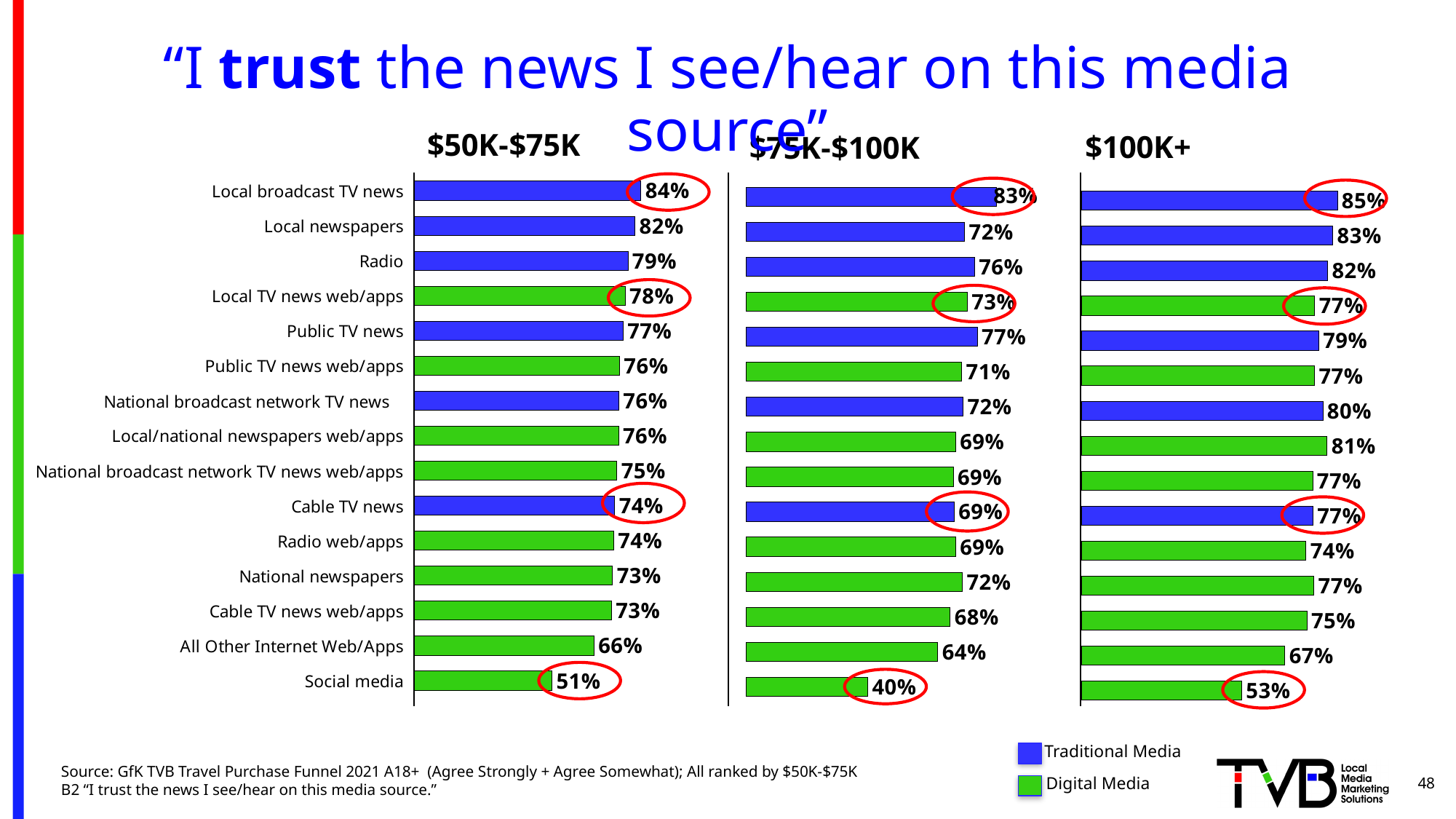
In the $50K-$75K chart, what is the value for Local broadcast TV news? 84% What kind of chart is used on this slide? Bar chart In the $75K-$100K chart, what is the value for Social media? 40% How many categories are shown in each chart? 15 In the $100K+ chart, what is the value for Cable TV news? 77% In the $100K+ chart, which category has the highest value? Local broadcast TV news In the $50K-$75K chart, which is larger: Local newspapers or Radio? Local newspapers In the $75K-$100K chart, what is the difference between Local broadcast TV news and Social media? 43 percentage points In the $75K-$100K chart, what is the value for Radio? 76% In the $50K-$75K chart, which category has the lowest value? Social media How many series does the legend list? 2 In the $100K+ chart, what is the difference between Local newspapers and All Other Internet Web/Apps? 16 percentage points